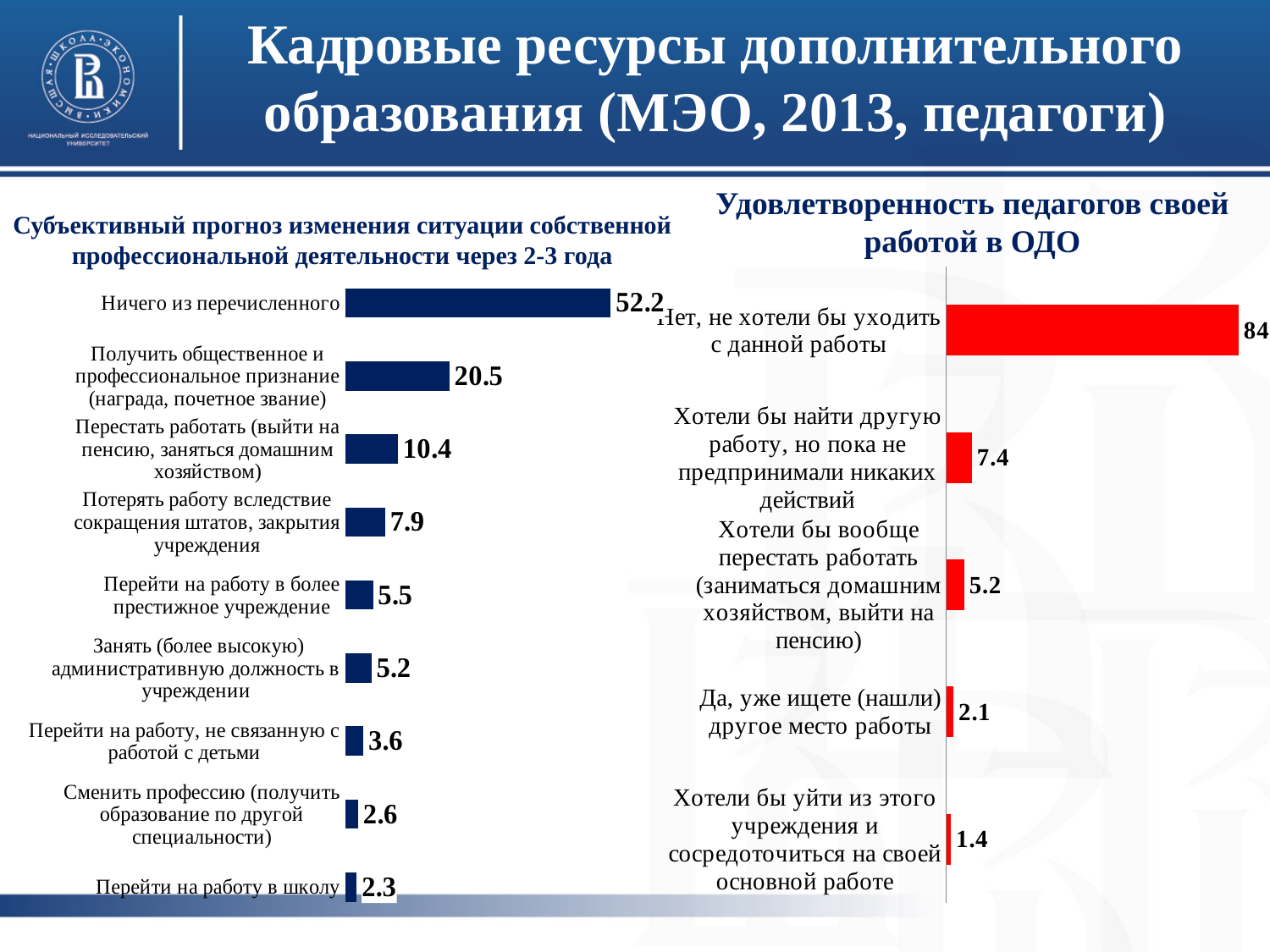
On the right chart, which category has the highest value? Нет, не хотели бы уходить с данной работы What type of chart is the right chart? Bar chart On the right chart (Удовлетворенность педагогов своей работой в ОДО), what is the value for "Нет, не хотели бы уходить с данной работы"? 84 On the left chart, how many categories are shown? 9 On the left chart, which category has the lowest value? Перейти на работу в школу On the right chart, what is the value for "Да, уже ищете (нашли) другое место работы"? 2.1 On the left chart, which is larger: "Перейти на работу в более престижное учреждение" or "Сменить профессию"? Перейти на работу в более престижное учреждение On the right chart, what is the difference between "Хотели бы найти другую работу, но пока не предпринимали никаких действий" and "Хотели бы уйти из этого учреждения и сосредоточиться на своей основной работе"? 6 On the right chart, how many categories are shown? 5 On the left chart, what is the value for "Перестать работать (выйти на пенсию, заняться домашним хозяйством)"? 10.4 On the left chart, what is the difference between "Получить общественное и профессиональное признание" and "Потерять работу вследствие сокращения штатов"? 12.6 On the left chart (Субъективный прогноз изменения ситуации...), what is the value for "Ничего из перечисленного"? 52.2